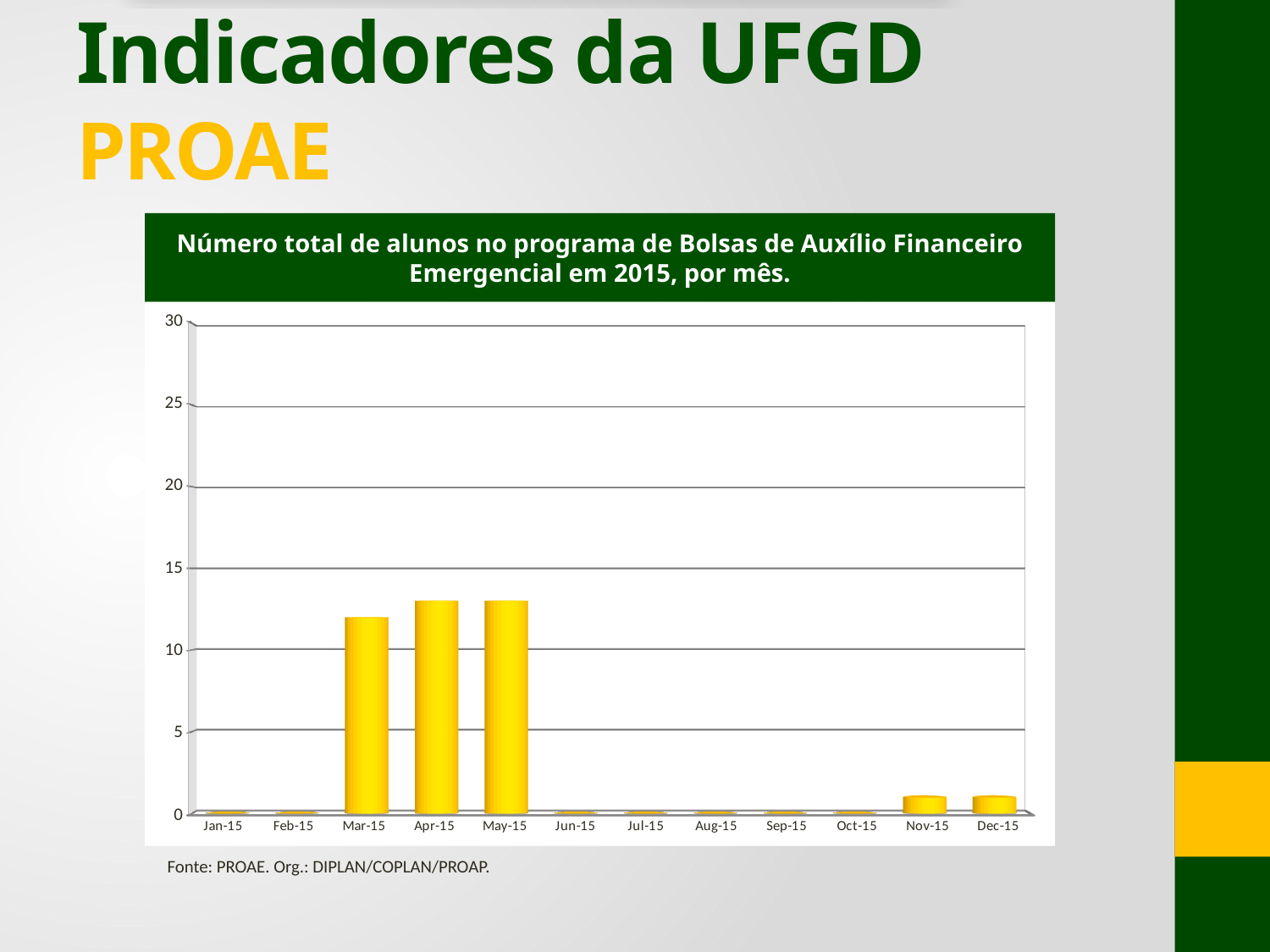
Is the value for Nov-15 greater or less than 5? less Which is larger, the value for Dec-15 or the value for May-15? May-15 What is the highest value shown on the y axis of the chart? 30 What is the title of the chart? Número total de alunos no programa de Bolsas de Auxílio Financeiro Emergencial em 2015, por mês. What kind of chart is shown on the slide? bar chart Which is larger, the value for Apr-15 or the value for Nov-15? Apr-15 Is the value for Mar-15 greater or less than 10? greater Is the value for Jun-15 greater or less than 5? less Which is larger, the value for Mar-15 or the value for Jun-15? Mar-15 How many months are shown on the x axis of the chart? 12